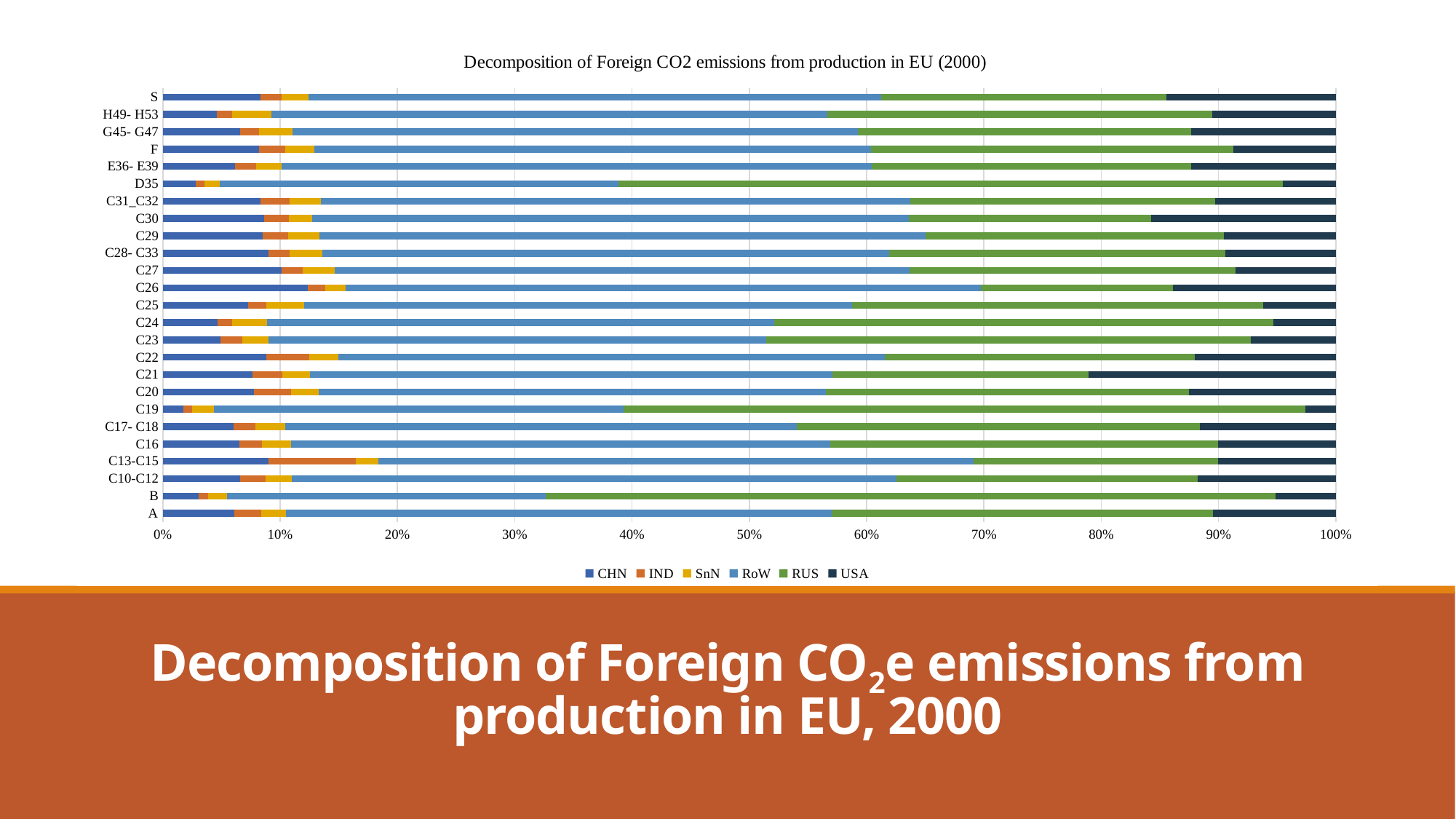
Which category has the largest IND share? C13-C15 Which series is listed last in the legend? USA What is the title of the chart? Decomposition of Foreign CO2 emissions from production in EU (2000) Which is larger, the RoW share for A or the RoW share for B? A How many series does the legend list? 6 What kind of chart is shown on the slide? Stacked bar chart Which category has the largest CHN share? C26 Which category has the smallest USA share? C19 How many categories (sectors) are plotted on the y axis? 25 Is the RUS share for B greater or less than 50%? greater Which category has the largest USA share? C21 Is the RoW share for C19 greater or less than 40%? less